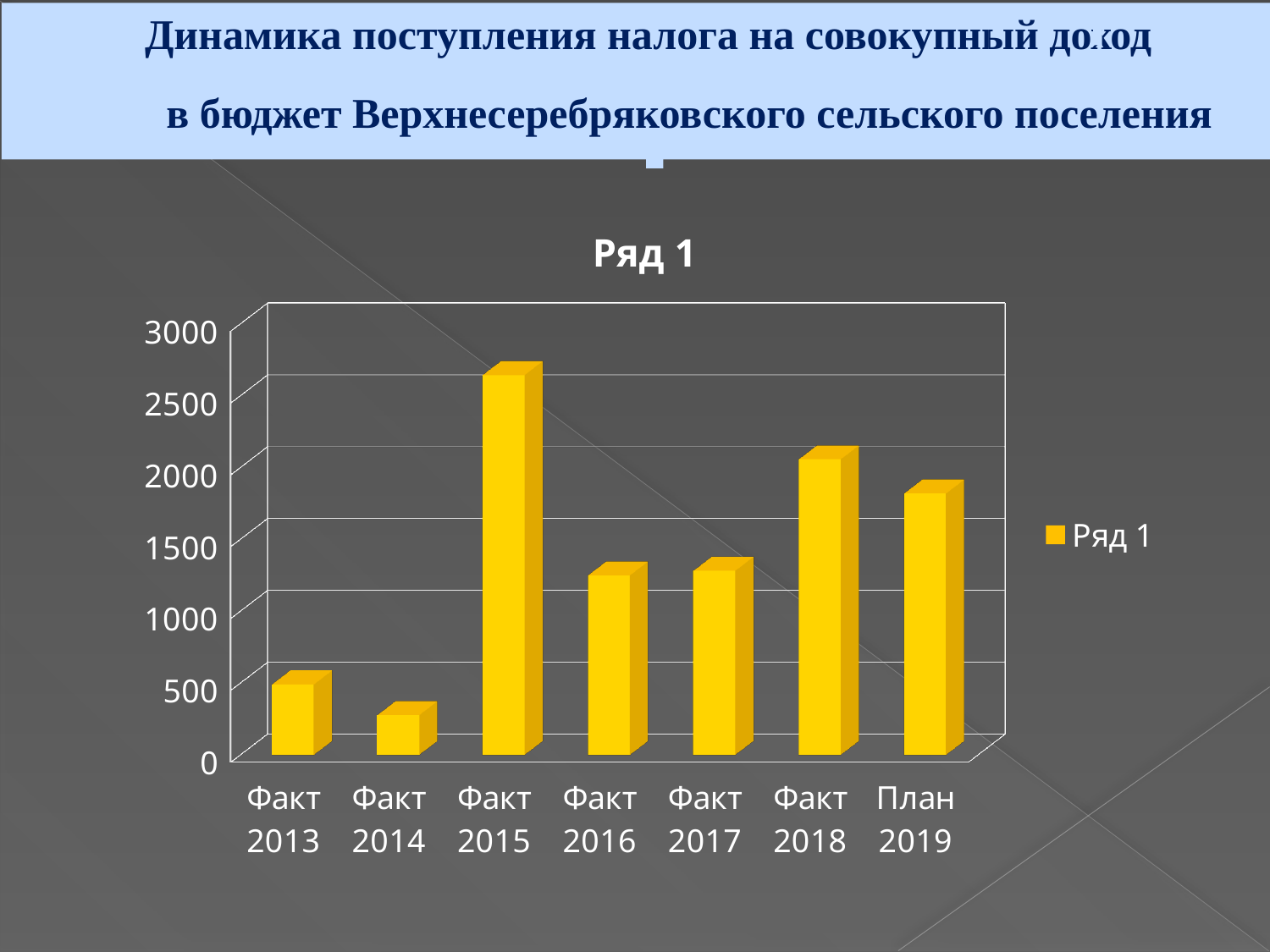
Which is larger, the value for Факт 2013 or the value for Факт 2014? Факт 2013 From Факт 2017 to Факт 2018, does the value rise or fall? rise Is the value for План 2019 greater or less than 1500? greater Is the value for Факт 2015 greater or less than 2500? greater What kind of chart is shown on the slide? bar chart How many categories are shown on the x axis of the chart? 7 How many series does the legend list? 1 What is the name of the series shown in the legend? Ряд 1 Which category has the highest value? Факт 2015 Is the value for Факт 2014 greater or less than 500? less Which is larger, the value for Факт 2015 or the value for Факт 2018? Факт 2015 Which category has the lowest value? Факт 2014